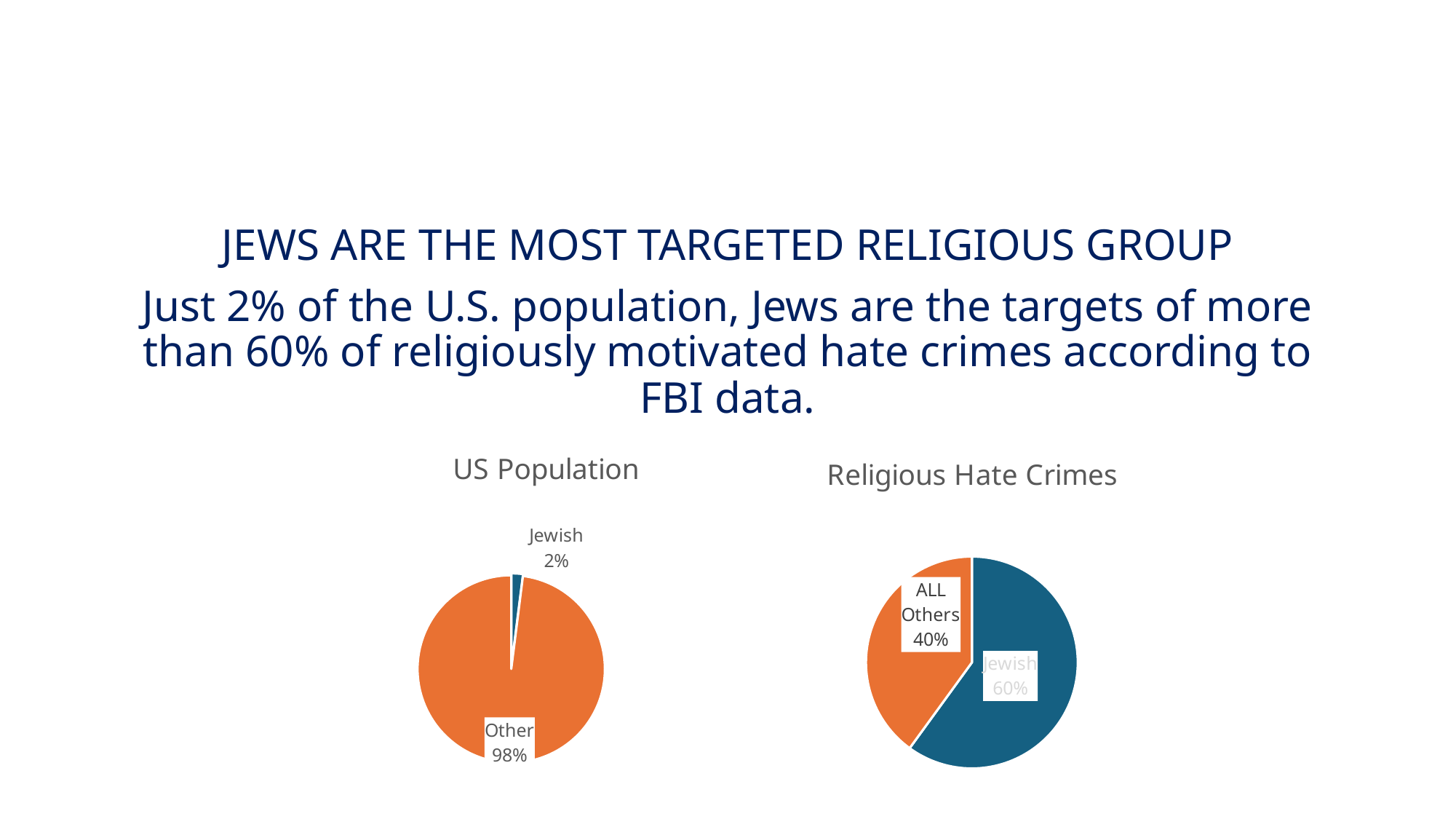
In the Religious Hate Crimes chart, what is the difference in percentage points between the Jewish and ALL Others slices? 20 What is the title of the chart on the right side of the slide? Religious Hate Crimes In the US Population chart, what share of the pie is labelled Jewish? 2% Which is larger: the Jewish share in the US Population chart or the Jewish share in the Religious Hate Crimes chart? Religious Hate Crimes In the Religious Hate Crimes chart, which slice is the largest? Jewish In the US Population chart, which slice is the smallest? Jewish In the US Population chart, what share of the pie is labelled Other? 98% In the Religious Hate Crimes chart, what share of the pie is labelled Jewish? 60% What type of chart is the US Population chart? Pie chart How many slices does the Religious Hate Crimes pie chart have? 2 In the Religious Hate Crimes chart, what share of the pie is labelled ALL Others? 40% In the Religious Hate Crimes chart, what colour is the Jewish slice? Blue